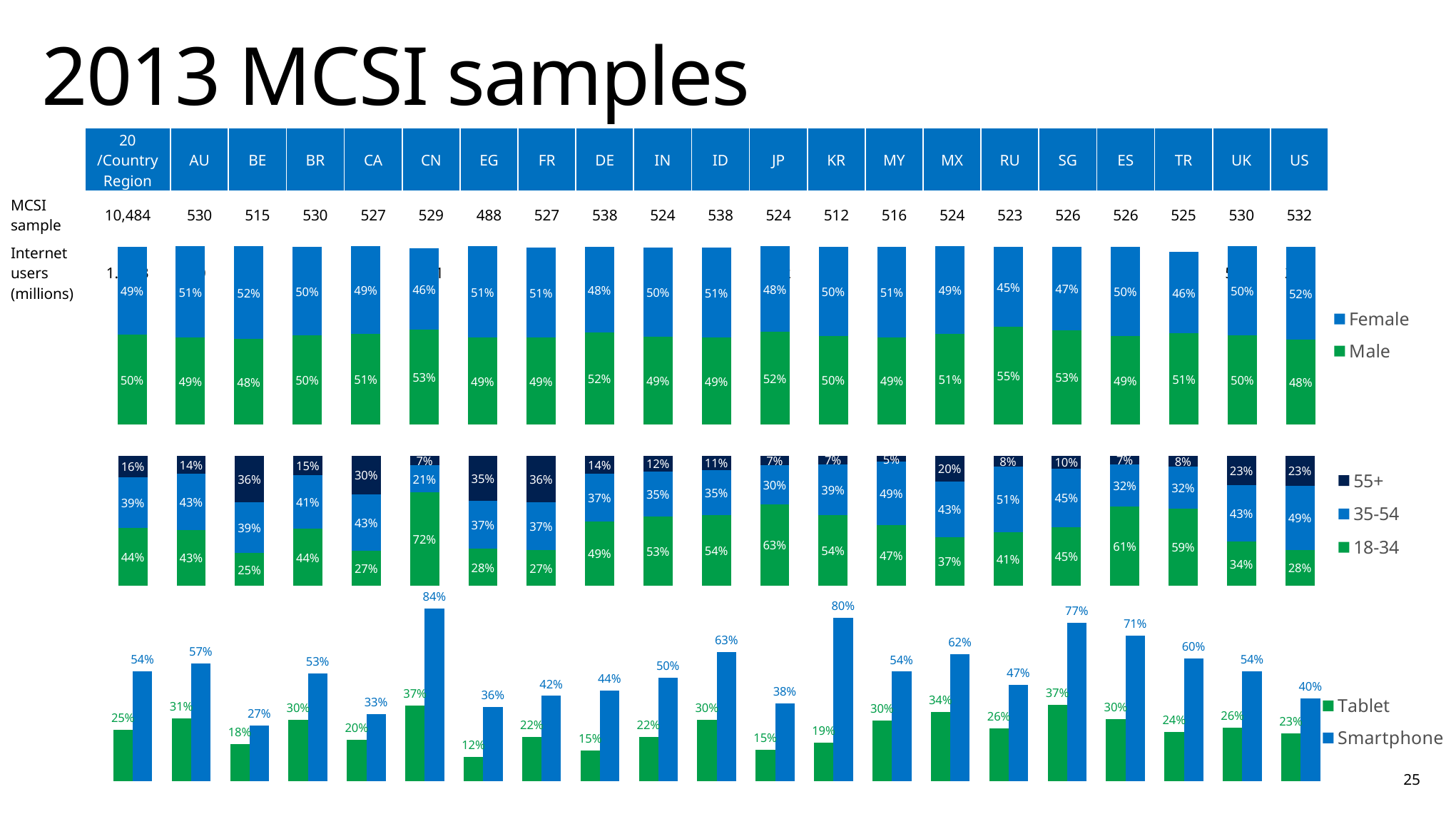
In the middle chart (age groups), what is the 18-34 value for CN? 72% In the bottom chart (Tablet/Smartphone), which country has the lowest Smartphone value? BE In the top chart (gender), what is the Male value for RU? 55% In the bottom chart (Tablet/Smartphone), which country has the lowest Tablet value? EG How many series does the legend of the bottom chart (Tablet/Smartphone) list? 2 In the bottom chart (Tablet/Smartphone), which country has the highest Smartphone value? CN In the bottom chart (Tablet/Smartphone), what is the Smartphone value for CN? 84% In the bottom chart (Tablet/Smartphone), what is the difference between the Smartphone and Tablet values for KR? 61 percentage points In the middle chart (age groups), what is the 55+ value for FR? 36% What kind of chart is the bottom chart (Tablet/Smartphone)? Bar chart In the bottom chart (Tablet/Smartphone), which is larger, the Smartphone value for SG or for ES? SG How many series does the legend of the middle chart (age groups) list? 3